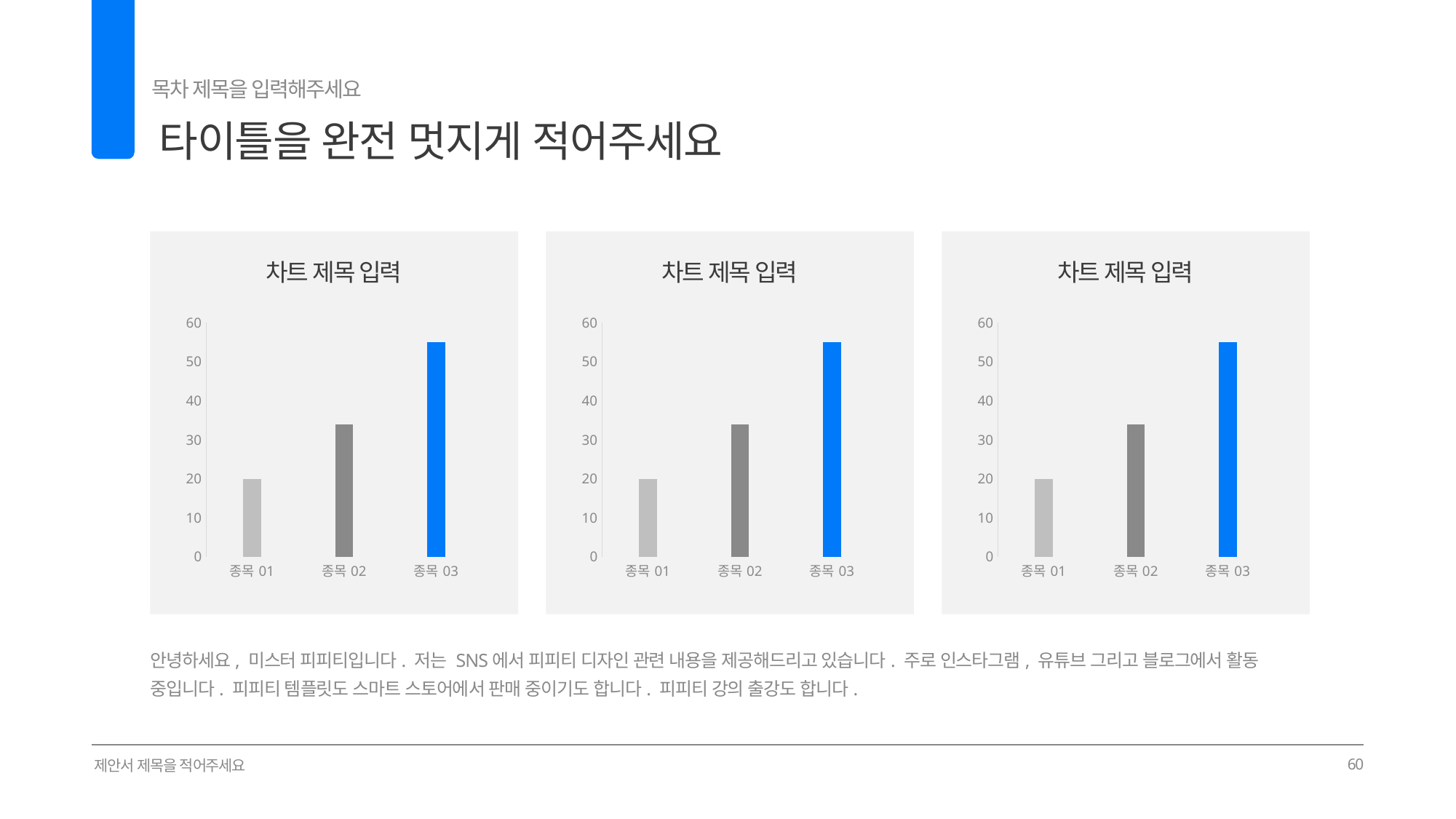
In the right chart, what is the value for 종목 01? 20 In the left chart, do the values rise or fall from 종목 01 to 종목 03? rise In the left chart, is the value for 종목 02 greater or less than 30? greater How many categories are shown in the middle chart? 3 In the middle chart, which category has the lowest value? 종목 01 In the right chart, is the value for 종목 03 greater or less than 50? greater What kind of chart is the right chart? bar chart In the right chart, what colour is the bar for 종목 03? blue In the middle chart, is the value for 종목 02 greater or less than 40? less In the left chart, which category has the highest value? 종목 03 In the left chart, which is larger, the value for 종목 01 or the value for 종목 02? 종목 02 What is the title of the middle chart? 차트 제목 입력